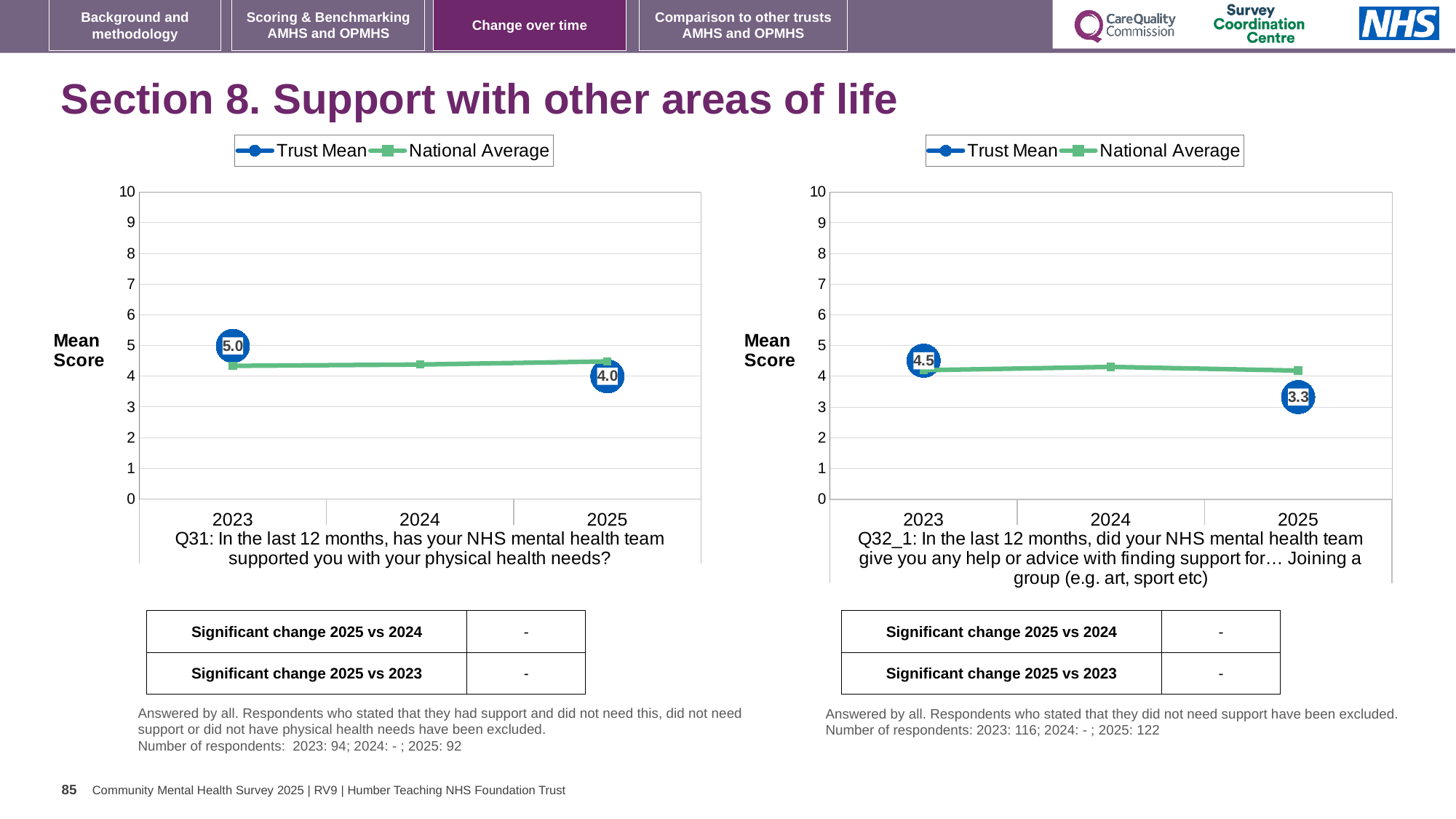
In the right chart (Q32_1), what is the Trust Mean for 2025? 3.3 In the left chart (Q31), does the Trust Mean rise or fall from 2023 to 2025? fall In the left chart (Q31), what is the Trust Mean for 2025? 4.0 In the right chart (Q32_1), what is the Trust Mean for 2023? 4.5 In the left chart (Q31), what is the Trust Mean for 2023? 5.0 How many series does the legend of the left chart (Q31) list? 2 In the left chart (Q31), by how much did the Trust Mean fall from 2023 to 2025? 1.0 How many years are shown on the x axis of the left chart (Q31)? 3 What kind of chart is the right chart (Q32_1)? line chart In the right chart (Q32_1), is the Trust Mean higher in 2023 or in 2025? 2023 In the right chart (Q32_1), is the National Average for 2024 greater or less than 5? less In the right chart (Q32_1), what is the difference between the Trust Mean in 2023 and in 2025? 1.2